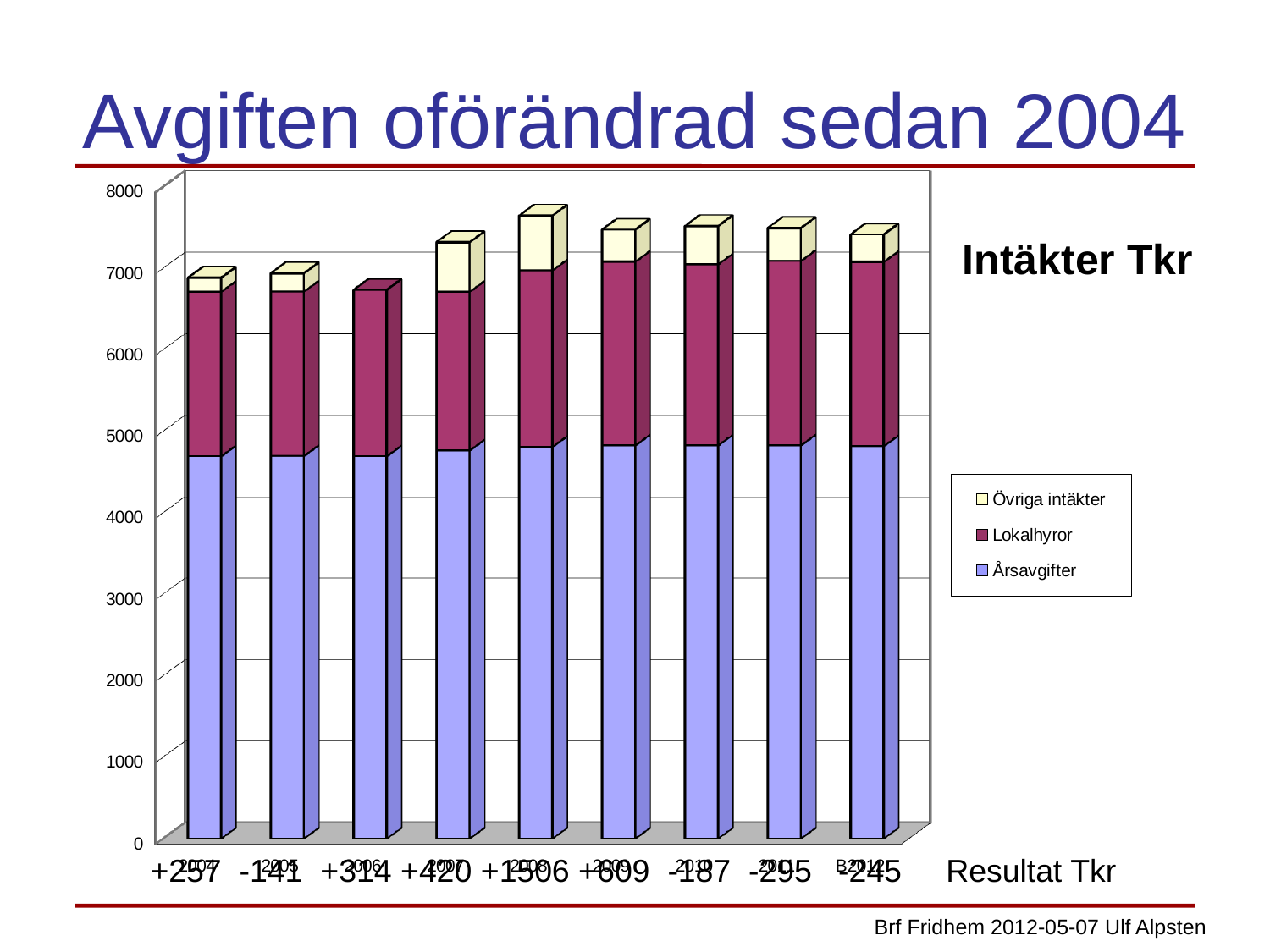
How many bars are plotted in the chart? 9 Is the total of the third bar from the left greater or less than 7000? less What kind of chart is shown on the slide? Stacked bar chart Is the total of the fifth bar from the left greater or less than 7000? greater Which bar has the lowest total, counting from the left? The third bar Which series is shown at the bottom of each stacked bar? Årsavgifter How many series does the legend list? 3 Is the Årsavgifter segment of the first bar from the left greater or less than 5000? less What are the three legend entries of the chart? Övriga intäkter, Lokalhyror, Årsavgifter What is the highest value shown on the vertical axis? 8000 Which has the larger total: the first bar from the left or the fourth bar from the left? The fourth bar Which bar has the highest total, counting from the left? The fifth bar